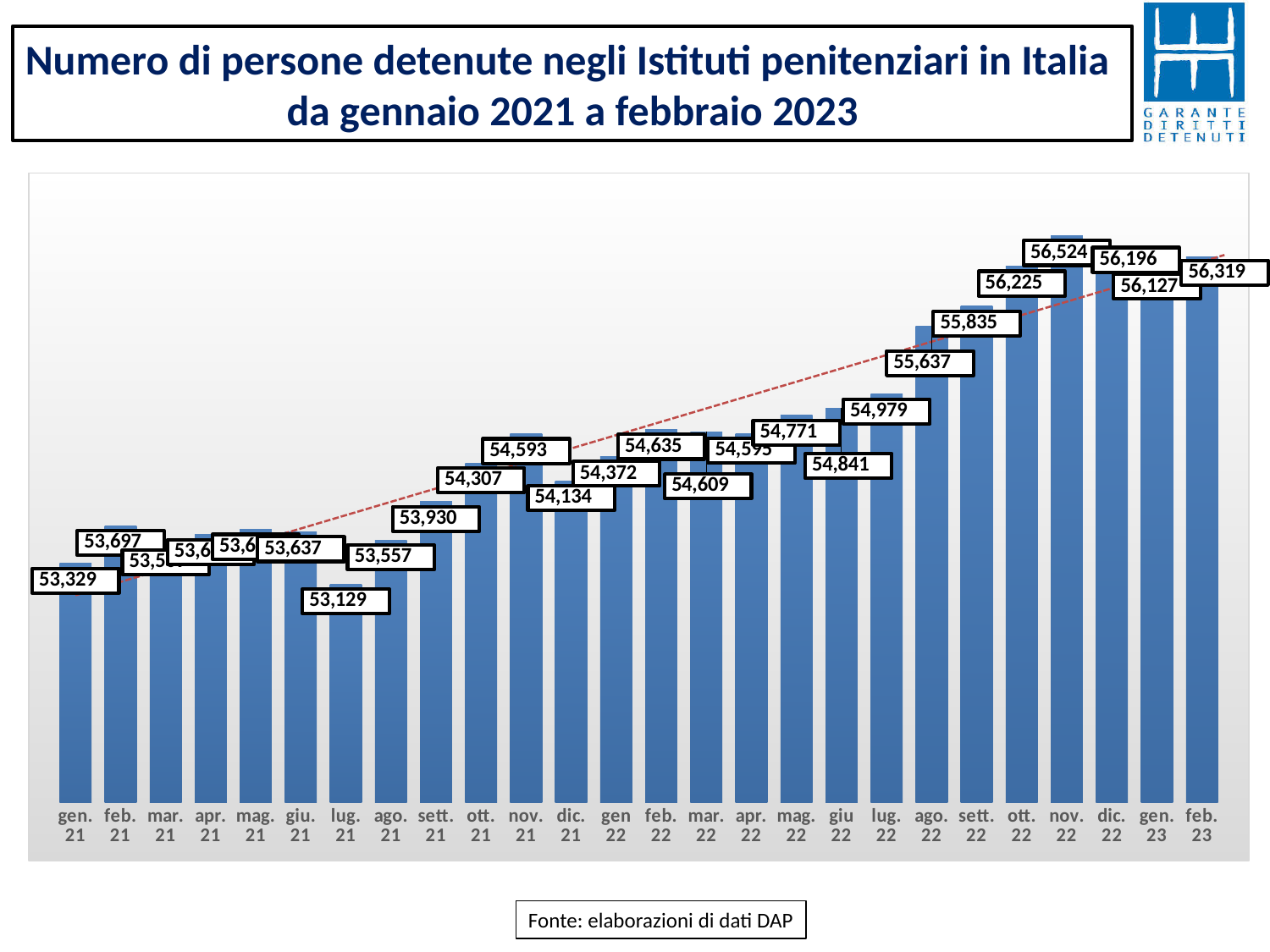
What value is shown for feb. 23? 56,319 What value is shown for nov. 22? 56,524 Which is larger, the value for sett. 22 or the value for ago. 22? sett. 22 How many months (bars) are plotted on the chart? 26 Which month has the lowest number of detained persons? lug. 21 What is the number of detained persons shown for gen. 21? 53,329 What value is shown for lug. 21? 53,129 What kind of chart is shown on the slide? bar chart What is the title of the chart on the slide? Numero di persone detenute negli Istituti penitenziari in Italia da gennaio 2021 a febbraio 2023 What is the difference between the values for nov. 22 and lug. 21? 3,395 Overall, do the values rise or fall from gen. 21 to feb. 23? rise Which month has the highest number of detained persons? nov. 22